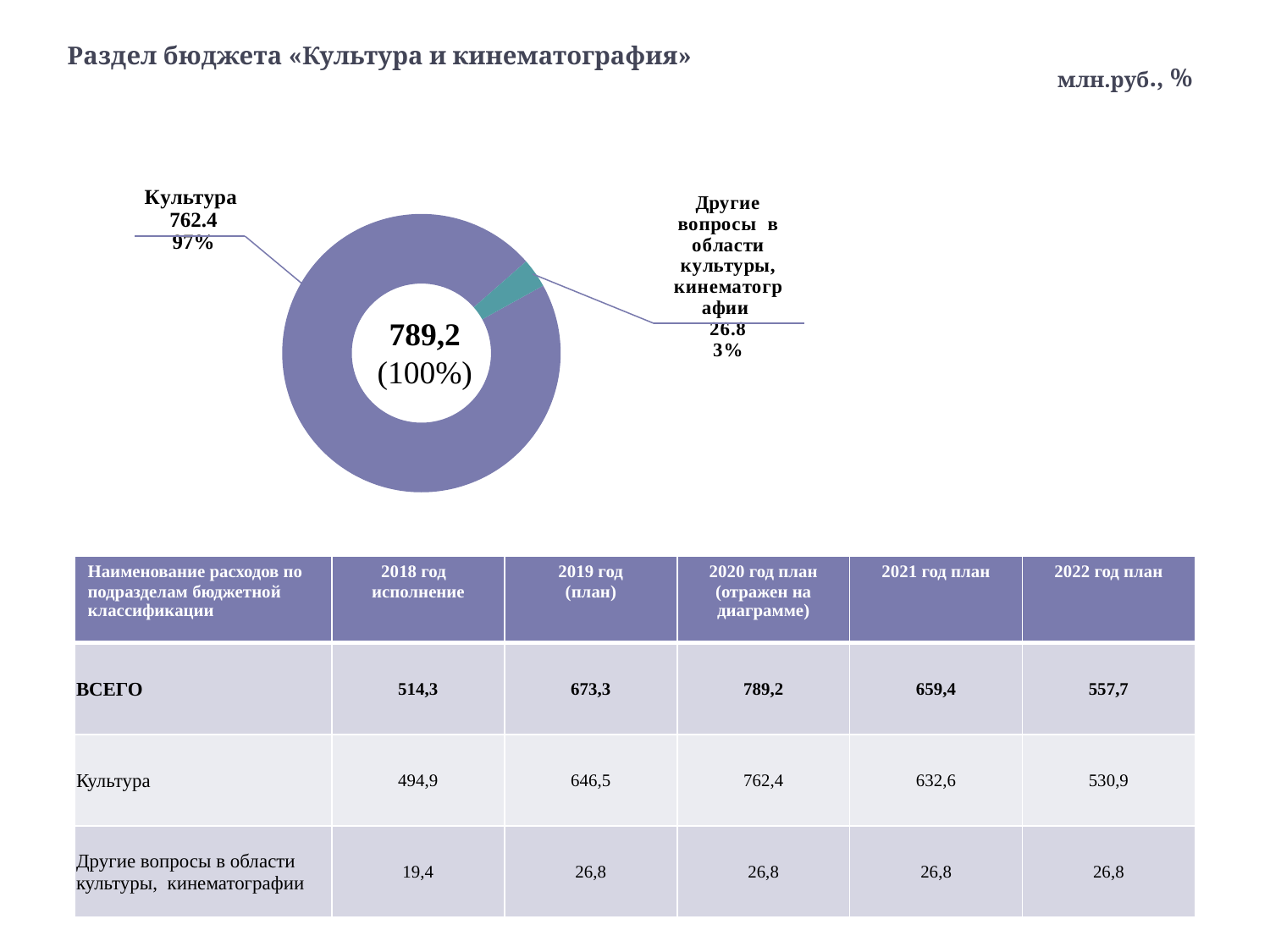
What is the difference between the "Культура" value and the "Другие вопросы в области культуры, кинематографии" value in the doughnut chart? 735.6 How many slices does the doughnut chart have? 2 What is the value shown for the "Культура" slice in the doughnut chart? 762.4 What units are indicated for the chart on the slide? млн.руб., % Which slice of the doughnut chart is the smallest? Другие вопросы в области культуры, кинематографии What share of the doughnut chart does the "Другие вопросы в области культуры, кинематографии" slice represent? 3% Which is larger in the doughnut chart: the "Культура" slice or the "Другие вопросы в области культуры, кинематографии" slice? Культура What total value is shown in the centre of the doughnut chart? 789,2 (100%) What kind of chart is shown on the slide? Doughnut (pie) chart Which slice of the doughnut chart is the largest? Культура What share of the doughnut chart does the "Культура" slice represent? 97% What is the value shown for the "Другие вопросы в области культуры, кинематографии" slice in the doughnut chart? 26.8